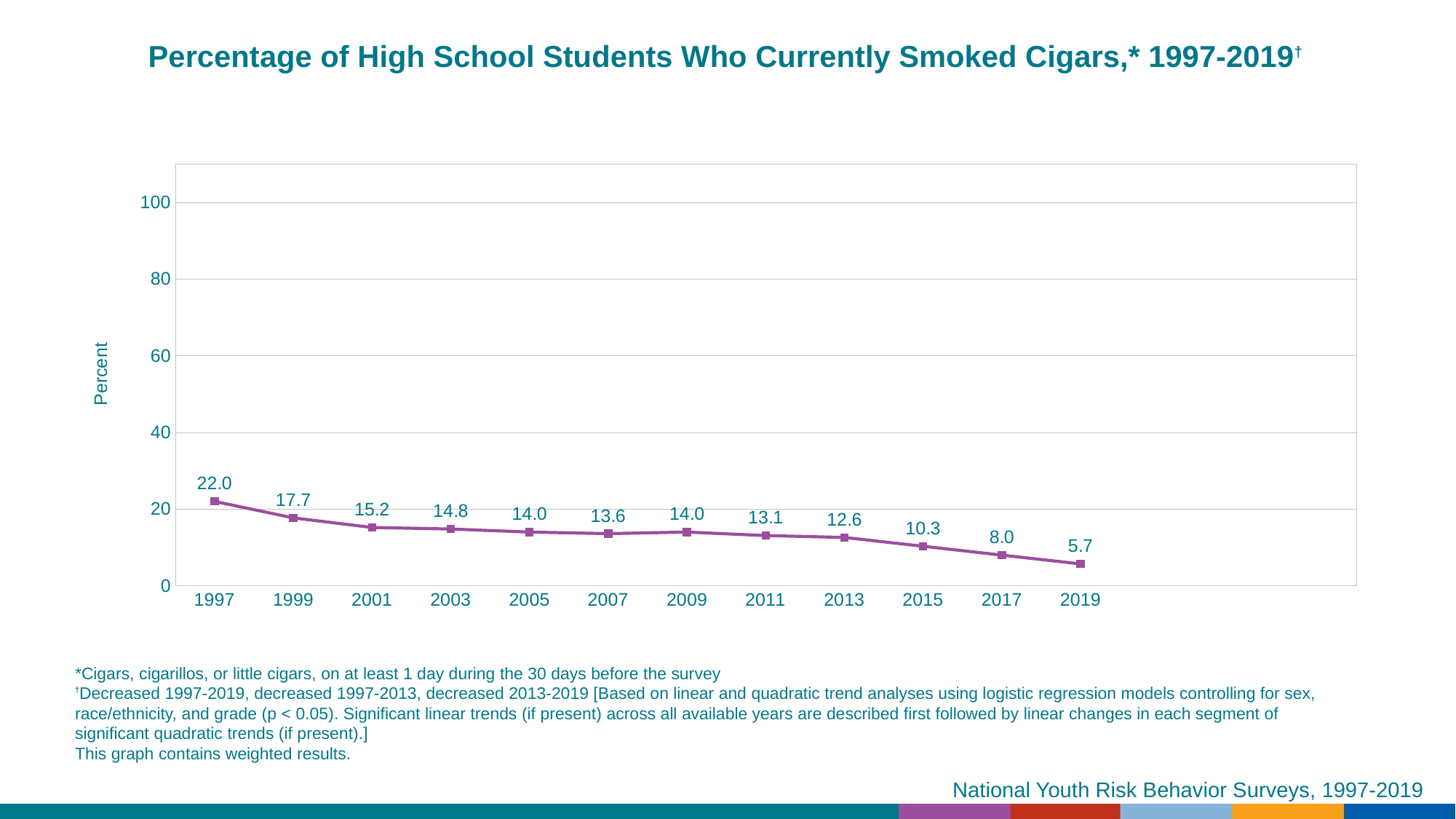
Do the values generally rise or fall from 1997 to 2019? Fall Which year has a larger value, 2009 or 2011? 2009 How many years are plotted on the chart? 12 Which year has the highest percentage of students who currently smoked cigars? 1997 Is the value for 1997 greater or less than 20? greater Which year has the lowest percentage of students who currently smoked cigars? 2019 What was the percentage of high school students who currently smoked cigars in 2019? 5.7 What is the difference between the 1997 value and the 2019 value? 16.3 What kind of chart is shown on the slide? Line chart What value is shown for 2013? 12.6 What was the percentage of high school students who currently smoked cigars in 1997? 22.0 What is the difference between the values for 2015 and 2017? 2.3